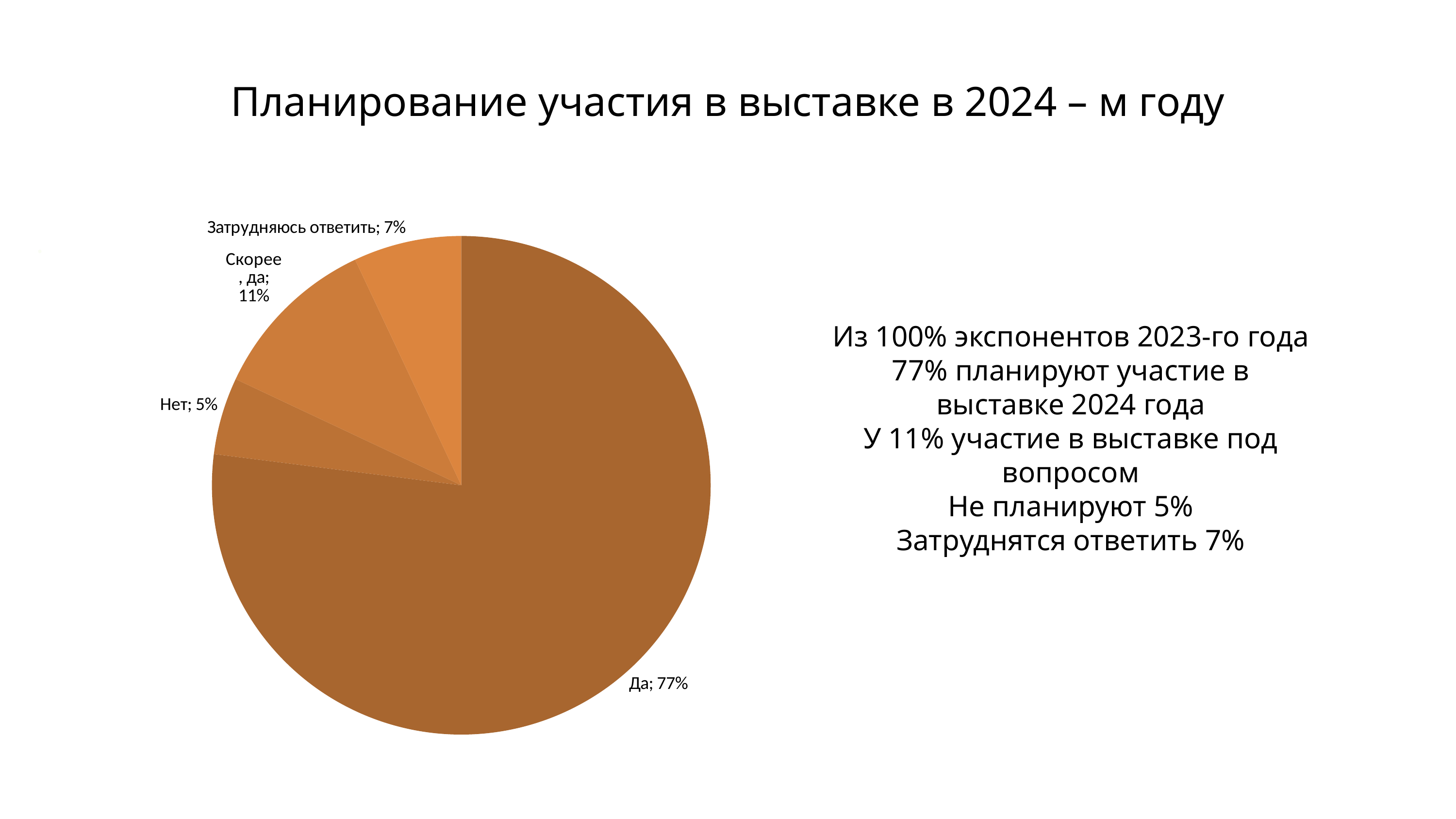
What is the title of the slide? Планирование участия в выставке в 2024 – м году What share of the pie does the "Да" slice represent? 77% How many slices does the pie chart have? 4 What is the value for "Скорее, да"? 11% Which is larger, "Затрудняюсь ответить" or "Нет"? Затрудняюсь ответить What is the difference between the "Да" and "Скорее, да" values? 66% What is the value for "Затрудняюсь ответить"? 7% What is the value for "Нет"? 5% What kind of chart is shown on the slide? Pie chart Which category has the smallest slice? Нет Which category has the largest slice? Да What is the difference between the "Скорее, да" and "Затрудняюсь ответить" values? 4%